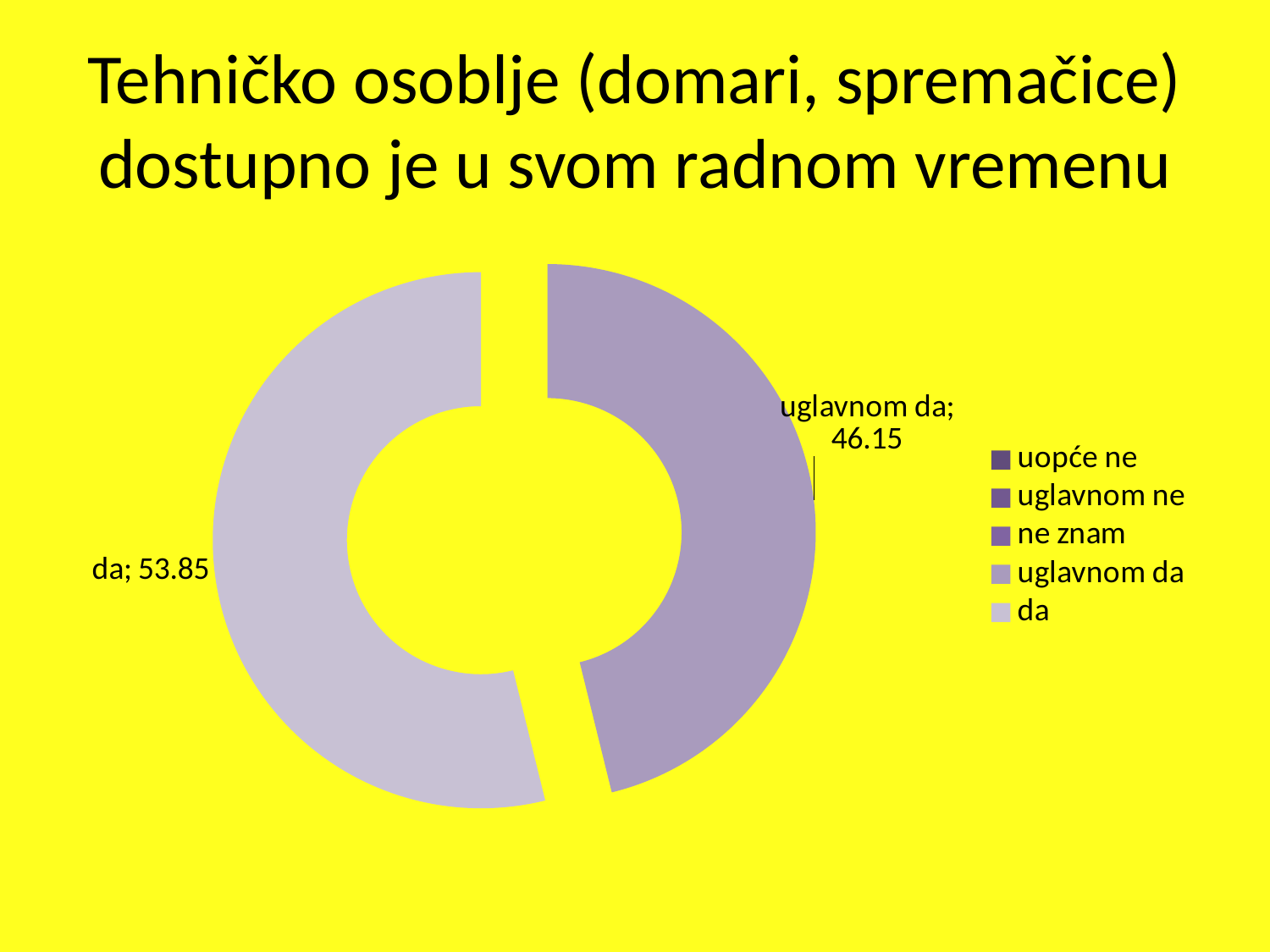
Which is larger, the value for "da" or the value for "uglavnom da"? da What is the title of the slide? Tehničko osoblje (domari, spremačice) dostupno je u svom radnom vremenu What is the difference between the values for "da" and "uglavnom da"? 7.70 How many entries does the legend list? 5 What is the value shown for the "da" slice? 53.85 Which category has the largest slice in the chart? da Which of the two labelled slices has the smaller value? uglavnom da What is the value shown for the "uglavnom da" slice? 46.15 Which legend entries have no visible slice in the chart? uopće ne, uglavnom ne, ne znam What is the total of the two labelled slice values? 100.00 What kind of chart is shown on the slide? Doughnut (pie) chart How many slices with data labels are shown in the chart? 2